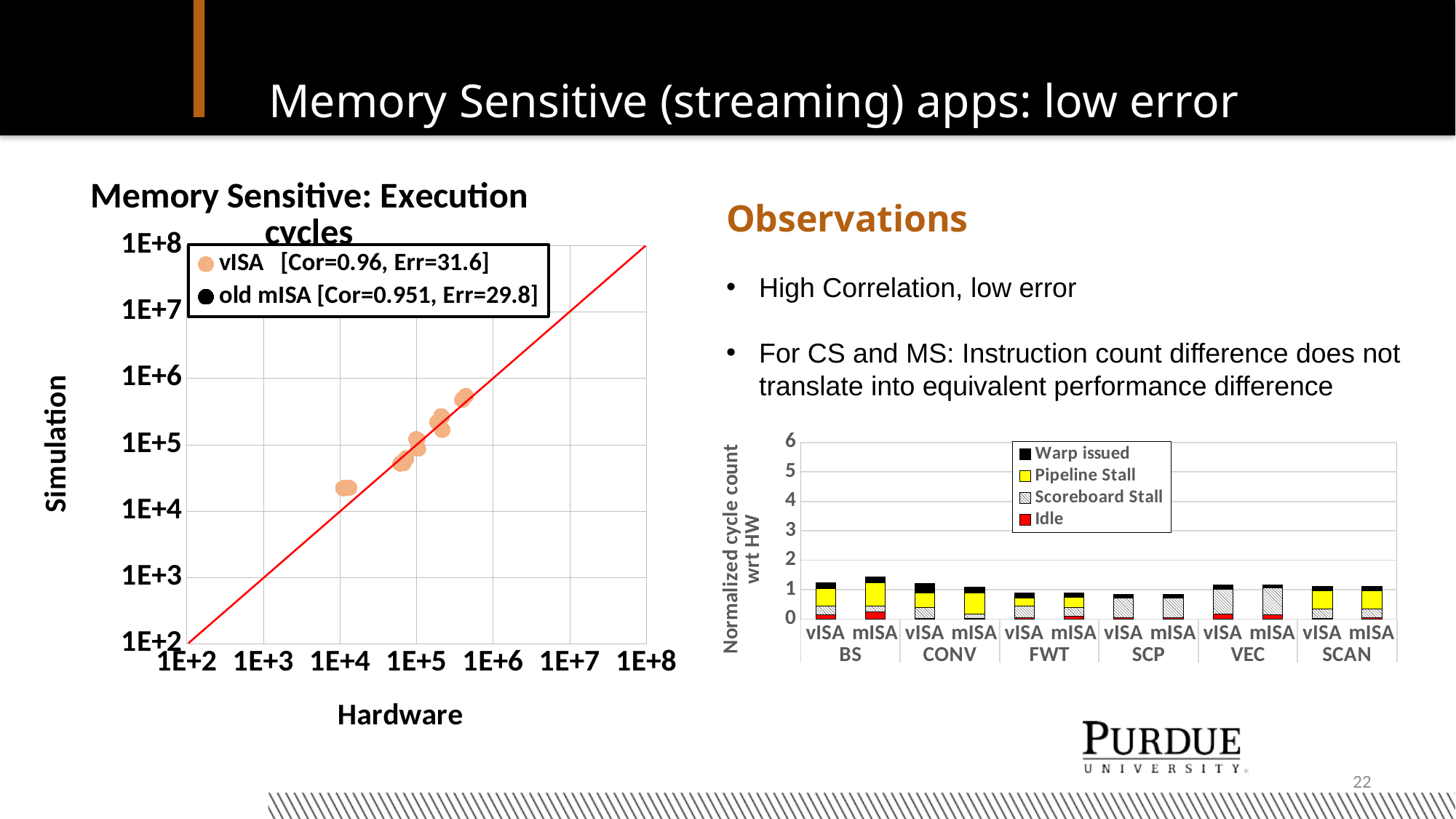
How many series does the legend of the 'Memory Sensitive: Execution cycles' chart list? 2 How many stacked bars are plotted in the 'Normalized cycle count wrt HW' chart? 12 What kind of chart is the 'Memory Sensitive: Execution cycles' chart on the left? scatter chart How many series does the legend of the 'Normalized cycle count wrt HW' chart list? 4 In the 'Normalized cycle count wrt HW' chart, which is larger, the total for vISA under BS or mISA under BS? mISA under BS What kind of chart is the 'Normalized cycle count wrt HW' chart on the right? bar chart In the 'Normalized cycle count wrt HW' chart, is the total for mISA under BS greater or less than 1? greater In the 'Normalized cycle count wrt HW' chart, which bar has the highest total? mISA under BS In the 'Memory Sensitive: Execution cycles' chart, what error value is given for old mISA in the legend? Err=29.8 In the 'Memory Sensitive: Execution cycles' chart, what correlation value is given for vISA in the legend? Cor=0.96 How many application groups are shown along the x axis of the 'Normalized cycle count wrt HW' chart? 6 In the 'Normalized cycle count wrt HW' chart, is the total for vISA under SCP greater or less than 1? less